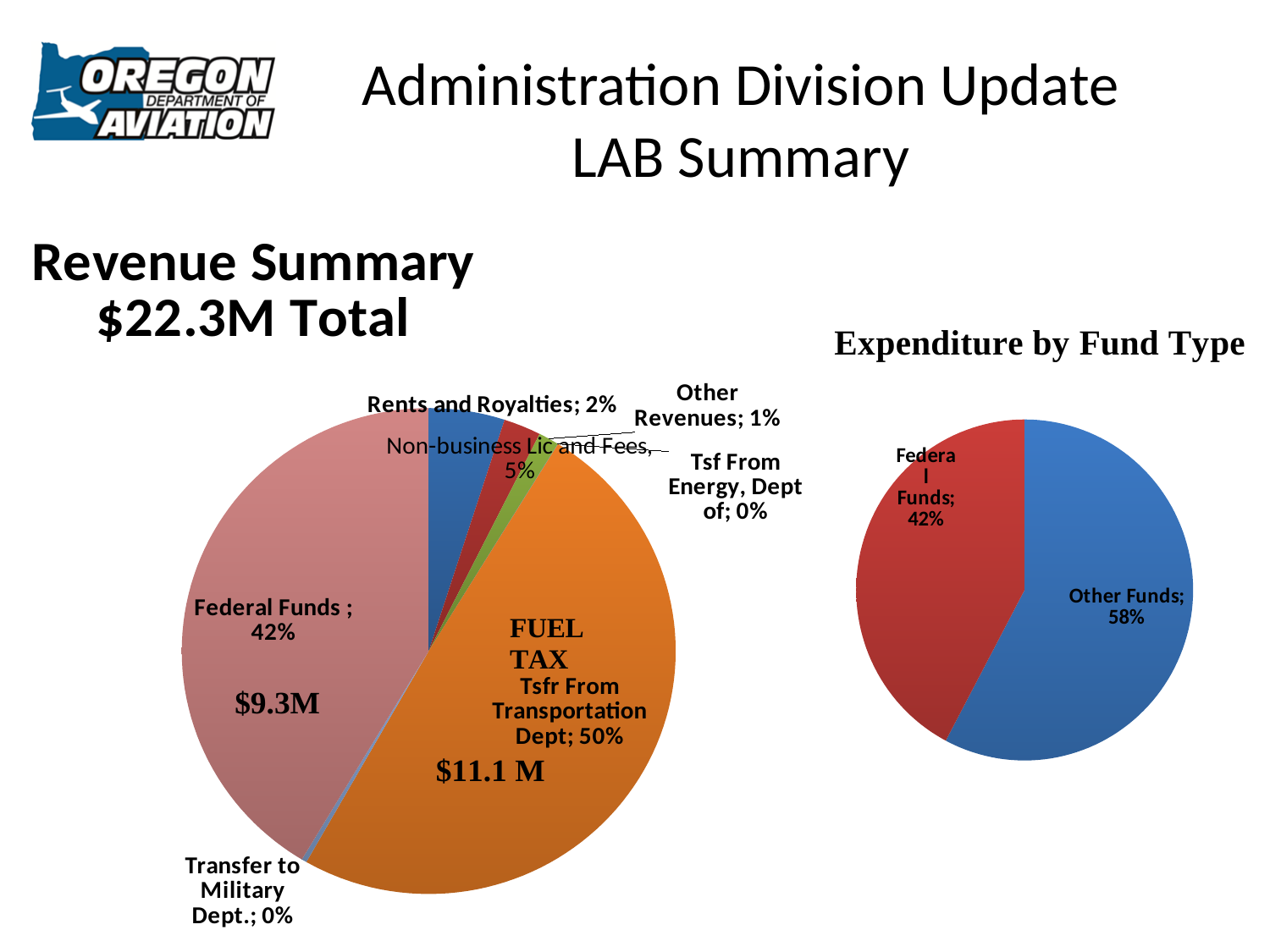
In the Revenue Summary pie chart, what dollar amount is printed on the Tsfr From Transportation Dept slice? $11.1 M In the Revenue Summary pie chart, what share is labelled for Federal Funds? 42% In the Revenue Summary pie chart, what share is labelled for Rents and Royalties? 2% In the Revenue Summary pie chart, what is the difference in percentage points between Tsfr From Transportation Dept and Federal Funds? 8 percentage points In the Revenue Summary pie chart, how many categories are labelled? 7 In the Revenue Summary pie chart, what share is labelled for Tsfr From Transportation Dept? 50% In the Revenue Summary pie chart, which category has the largest share? Tsfr From Transportation Dept What kind of chart is the Expenditure by Fund Type chart? Pie chart In the Revenue Summary pie chart, what dollar amount is printed on the Federal Funds slice? $9.3M In the Expenditure by Fund Type chart, which fund type has the larger share, Federal Funds or Other Funds? Other Funds